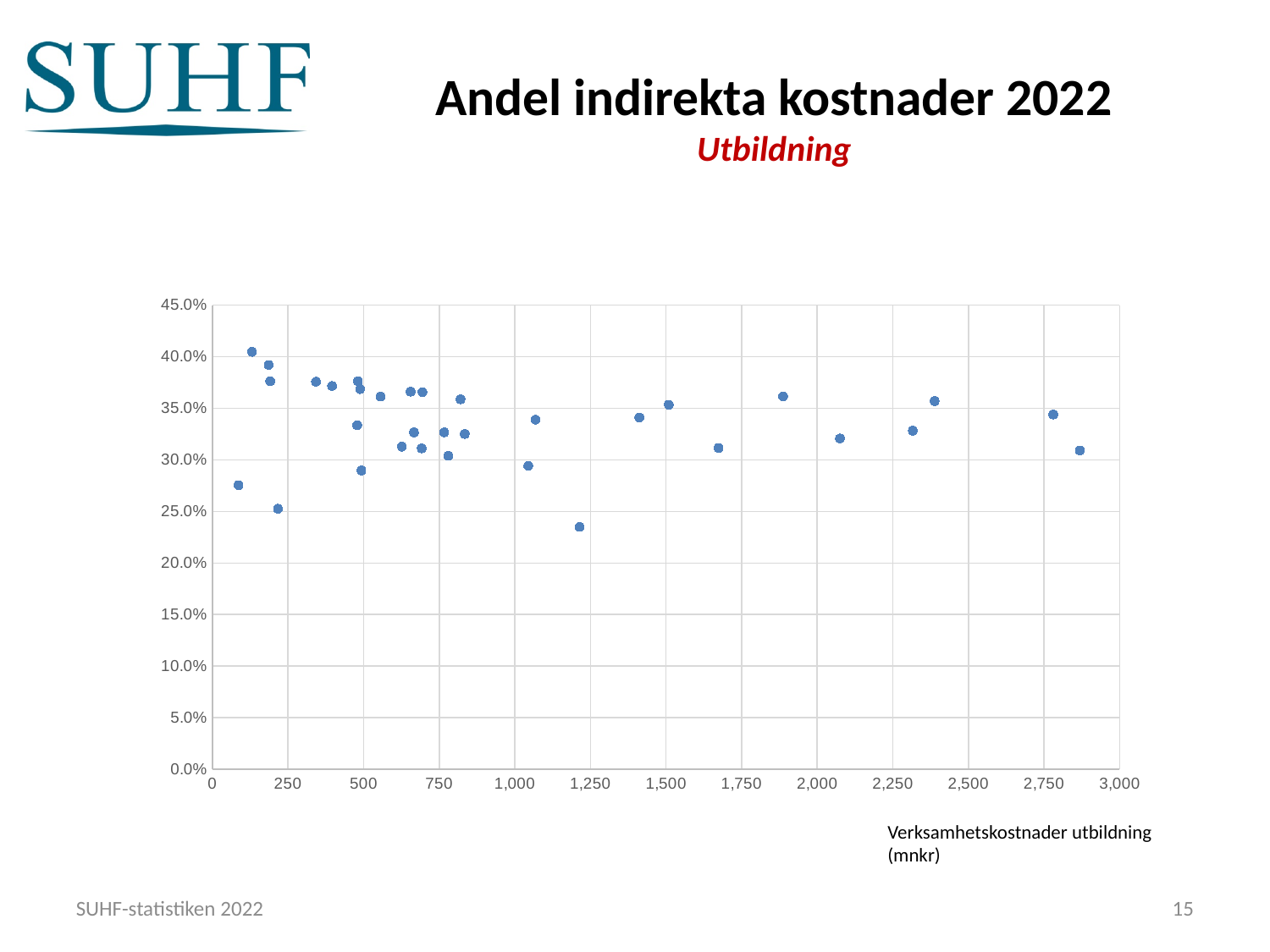
Are any points on the chart above 45.0%? No Is the highest point on the chart greater or less than 35.0%? greater What is the highest value shown on the y axis? 45.0% What kind of chart is shown on the slide? Scatter chart What is the title of the chart on the slide? Andel indirekta kostnader 2022 What is the label of the x axis of the chart? Verksamhetskostnader utbildning (mnkr)